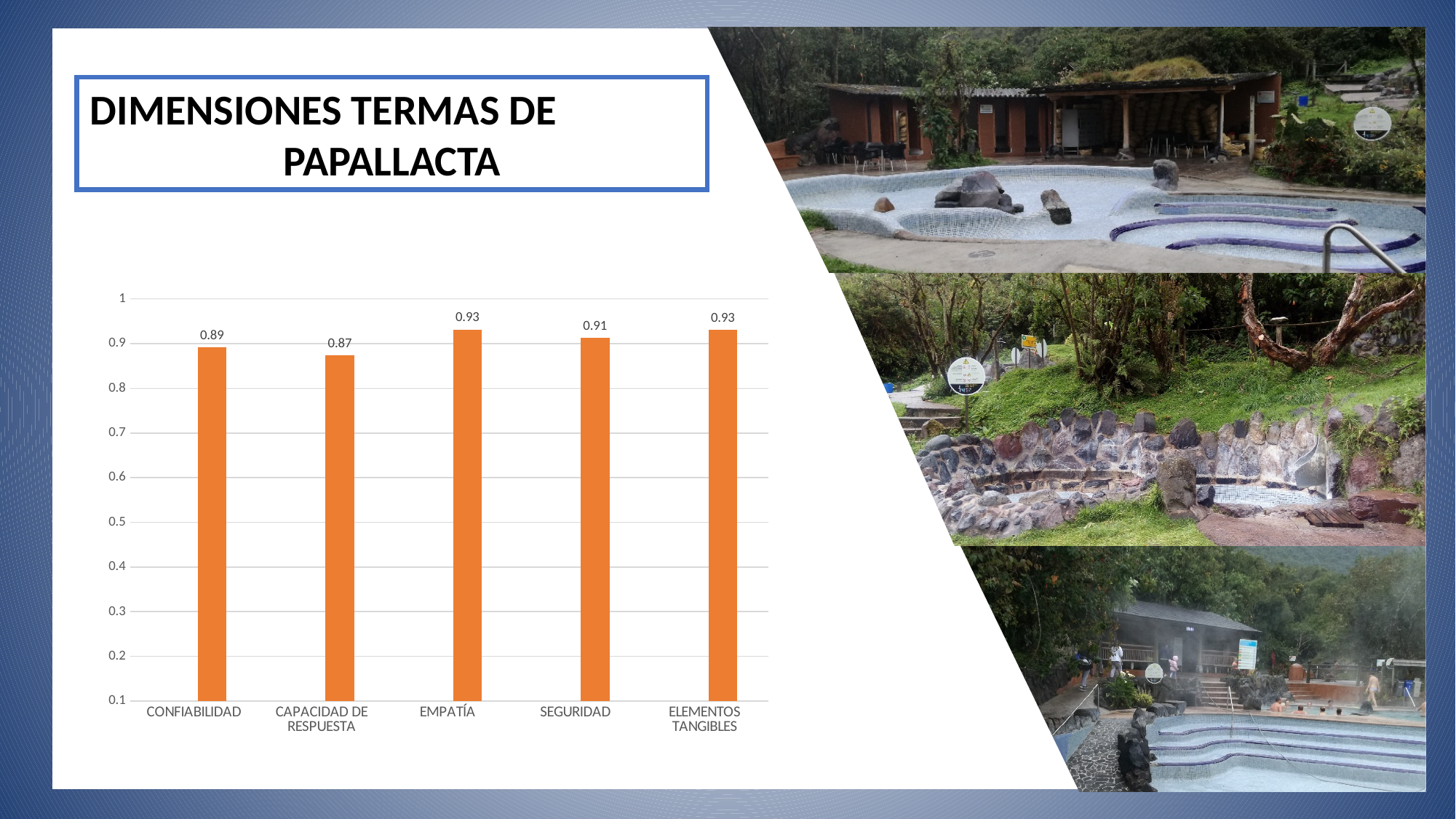
What colour are the bars in the chart? Orange What is the value for CAPACIDAD DE RESPUESTA? 0.87 What kind of chart is shown on the slide? Bar chart What is the value for EMPATÍA? 0.93 How many categories are shown in the chart? 5 What is the difference between the values for SEGURIDAD and CONFIABILIDAD? 0.02 Which category has the lowest value? CAPACIDAD DE RESPUESTA Which is larger, the value for SEGURIDAD or the value for CAPACIDAD DE RESPUESTA? SEGURIDAD What is the value for CONFIABILIDAD? 0.89 What is the value for ELEMENTOS TANGIBLES? 0.93 What is the value for SEGURIDAD? 0.91 What is the difference between the values for EMPATÍA and CAPACIDAD DE RESPUESTA? 0.06